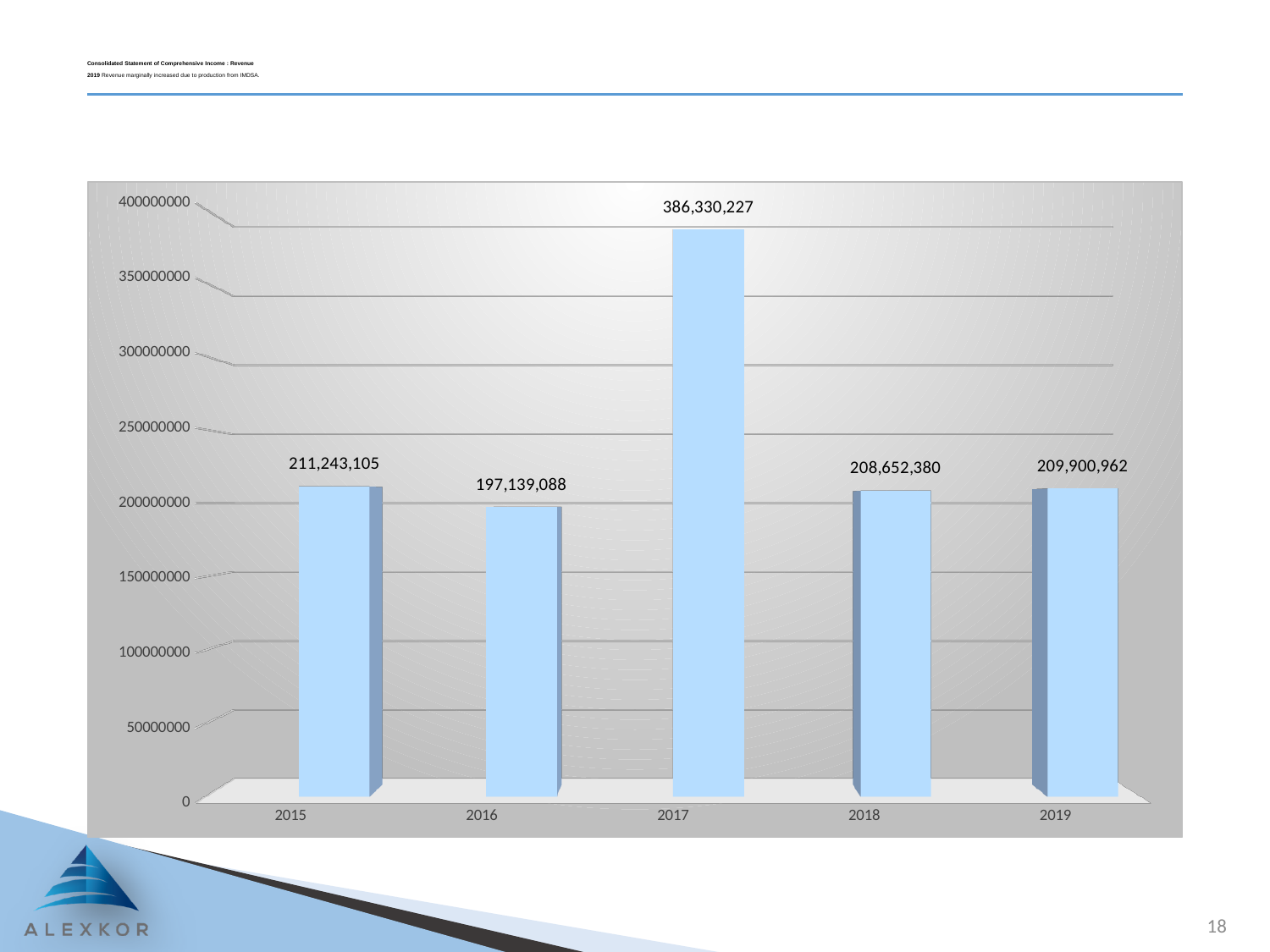
What is the difference between the values for 2017 and 2016? 189,191,139 Does the value rise or fall from 2017 to 2018? fall Which year has the highest value? 2017 What is the value shown for 2017? 386,330,227 What kind of chart is shown on the slide? bar chart How many years are shown on the x axis? 5 Which is larger, the value for 2015 or the value for 2016? 2015 Is the value for 2016 greater or less than 200000000? less What is the value shown for 2019? 209,900,962 Which year has the lowest value? 2016 What is the value shown for 2016? 197,139,088 What is the difference between the values for 2019 and 2018? 1,248,582